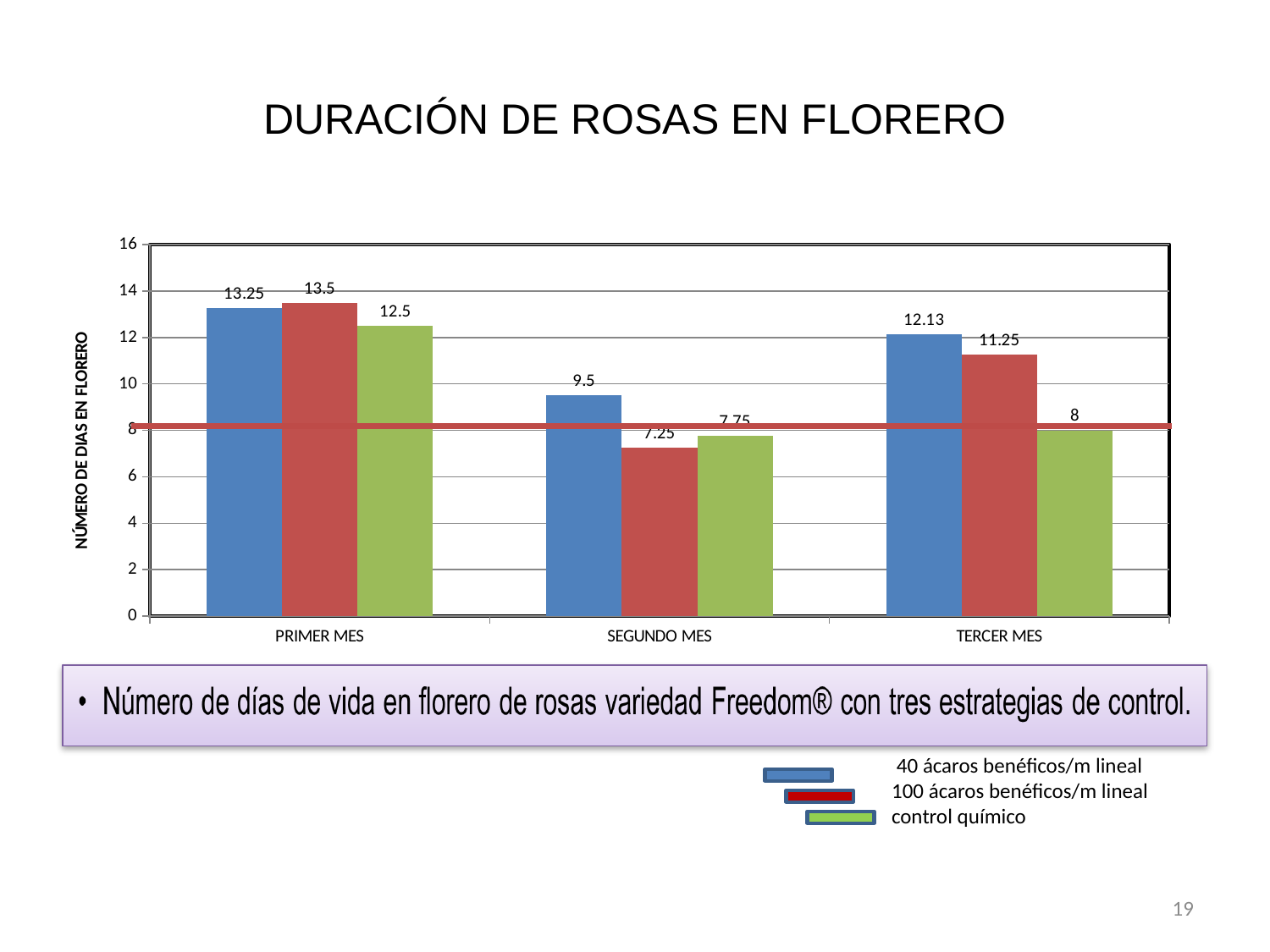
What is the value for 100 ácaros benéficos/m lineal in SEGUNDO MES? 7.25 What is the value for 40 ácaros benéficos/m lineal in PRIMER MES? 13.25 Which is larger in SEGUNDO MES: the value for 40 ácaros benéficos/m lineal or the value for control químico? 40 ácaros benéficos/m lineal What is the value for control químico in TERCER MES? 8 What is the difference between the 40 ácaros benéficos/m lineal value and the control químico value in TERCER MES? 4.13 What type of chart is shown on the slide? bar chart Which month has the highest value for control químico? PRIMER MES Which month has the lowest value for 100 ácaros benéficos/m lineal? SEGUNDO MES How many series does the legend list? 3 What is the title of the chart? DURACIÓN DE ROSAS EN FLORERO What is the value for 40 ácaros benéficos/m lineal in TERCER MES? 12.13 How many month categories are shown on the x axis? 3